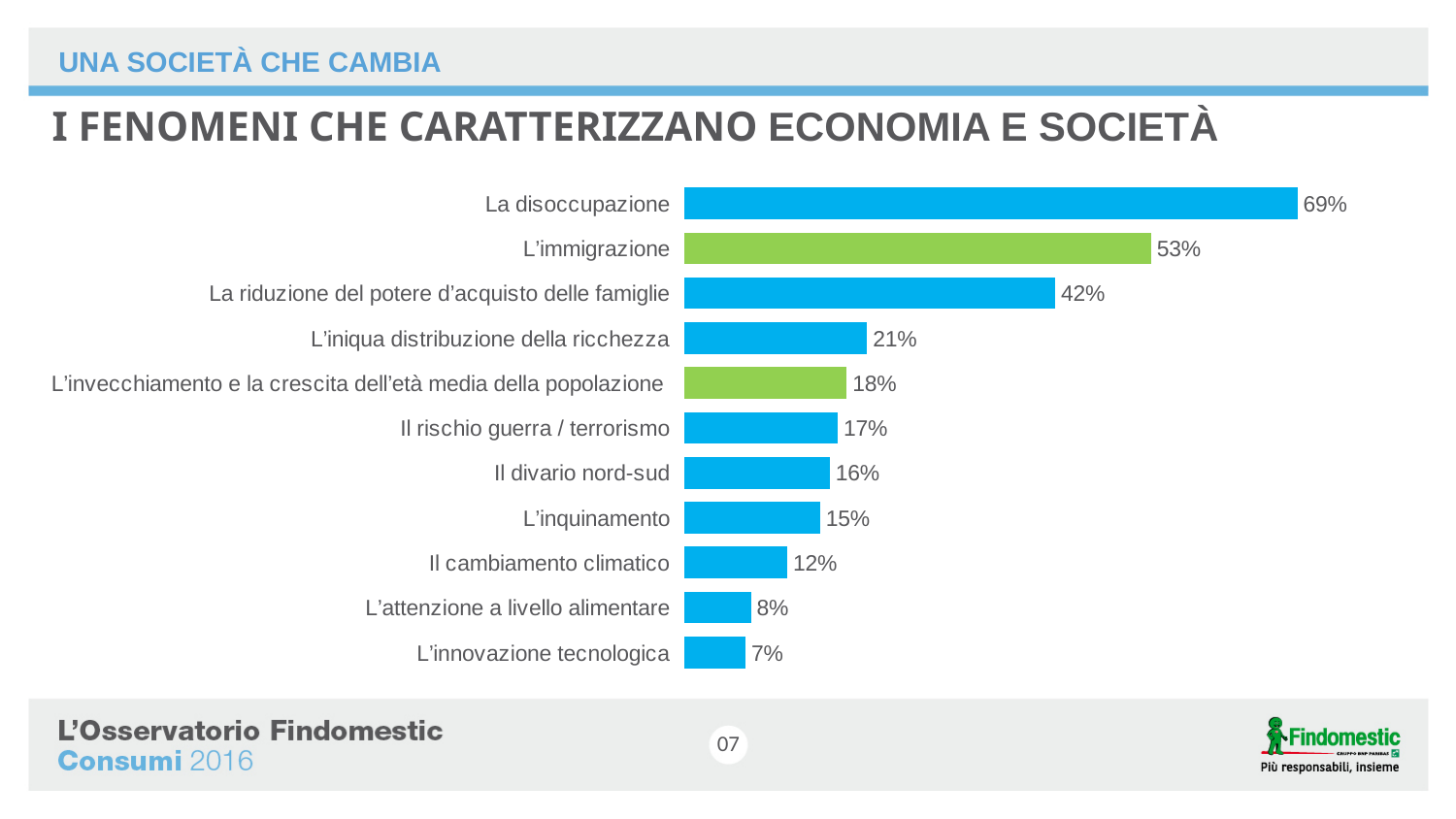
Which category has the highest value? La disoccupazione What is the difference between the values for La riduzione del potere d'acquisto delle famiglie and L'iniqua distribuzione della ricchezza? 21% What kind of chart is shown on the slide? Bar chart Which category has the lowest value? L'innovazione tecnologica How many categories are shown in the chart? 11 What is the value for L'immigrazione? 53% What is the value for Il rischio guerra / terrorismo? 17% What is the value for La disoccupazione? 69% What is the value for L'innovazione tecnologica? 7% Which two categories are shown with green bars? L'immigrazione and L'invecchiamento e la crescita dell'età media della popolazione What is the difference between the values for La disoccupazione and L'immigrazione? 16% Which is larger, the value for Il divario nord-sud or the value for Il cambiamento climatico? Il divario nord-sud